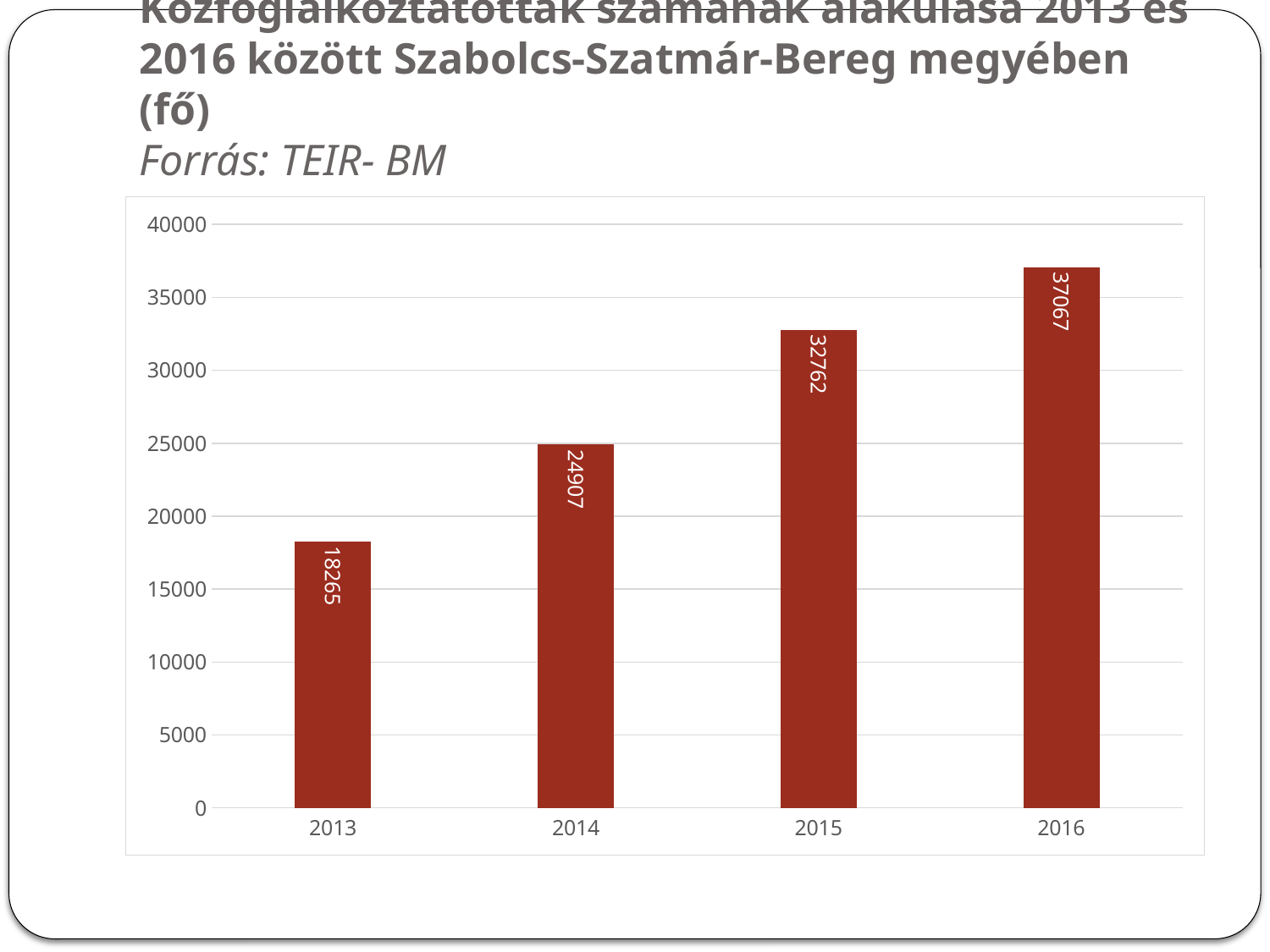
What is the value for 2015? 32762 Do the values rise or fall from 2013 to 2016? rise What is the value for 2014? 24907 What is the difference between the values for 2016 and 2013? 18802 Which year has the highest value? 2016 What is the difference between the values for 2015 and 2014? 7855 How many years are shown on the x axis? 4 Is the value for 2016 greater or less than 35000? greater What is the value for 2013? 18265 Which is larger, the value for 2014 or the value for 2015? 2015 What is the value for 2016? 37067 Which year has the lowest value? 2013